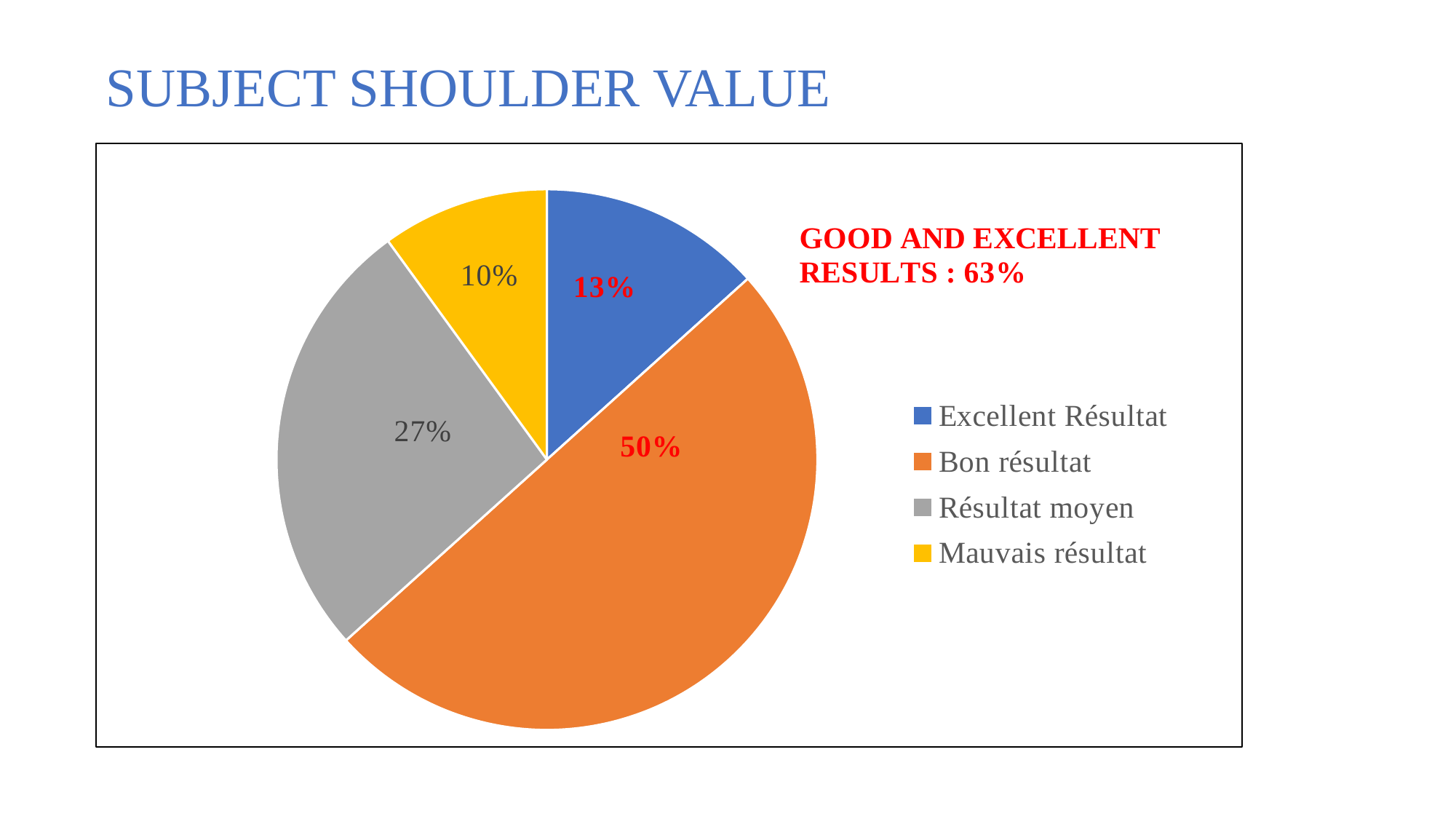
What is the combined share of Excellent Résultat and Bon résultat? 63% What share of the pie does Bon résultat represent? 50% How many categories does the pie chart show? 4 Which is larger, the share of Résultat moyen or the share of Excellent Résultat? Résultat moyen What share of the pie does Résultat moyen represent? 27% Which category has the largest slice of the pie? Bon résultat What share of the pie does Excellent Résultat represent? 13% Which category has the smallest slice of the pie? Mauvais résultat What kind of chart is shown on the slide? pie chart What is the difference between the shares of Bon résultat and Résultat moyen? 23% What colour is the slice for Résultat moyen? grey